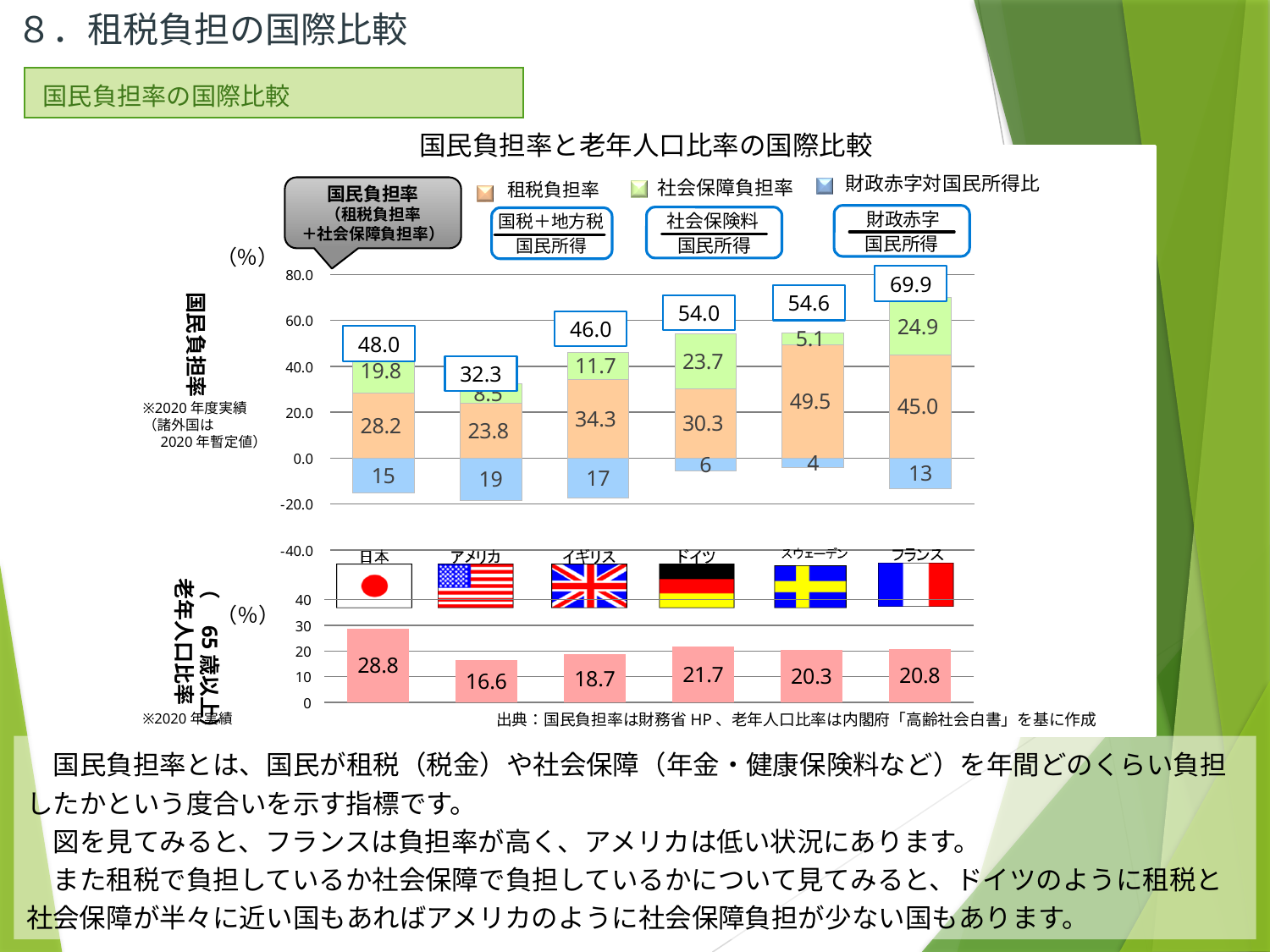
In the top chart (国民負担率), which is larger: the 租税負担率 of スウェーデン or of フランス? スウェーデン In the top chart (国民負担率), what is the 社会保障負担率 value for フランス? 24.9 In the top chart (国民負担率), how many series does the legend list? 3 In the top chart (国民負担率), what is the 租税負担率 value for イギリス? 34.3 In the top chart (国民負担率), what is the difference between the 租税負担率 of 日本 and アメリカ? 4.4 In the top chart (国民負担率), which country has the highest 国民負担率 total? フランス In the bottom chart (老年人口比率), how many countries are shown? 6 In the top chart (国民負担率), what is the total 国民負担率 for 日本 (租税負担率 plus 社会保障負担率)? 48.0 In the top chart (国民負担率), which country has the lowest 国民負担率 total? アメリカ In the bottom chart (老年人口比率), what is the value for ドイツ? 21.7 In the bottom chart (老年人口比率), which country has the highest value? 日本 In the top chart (国民負担率), what is the 財政赤字対国民所得比 value for アメリカ? 19